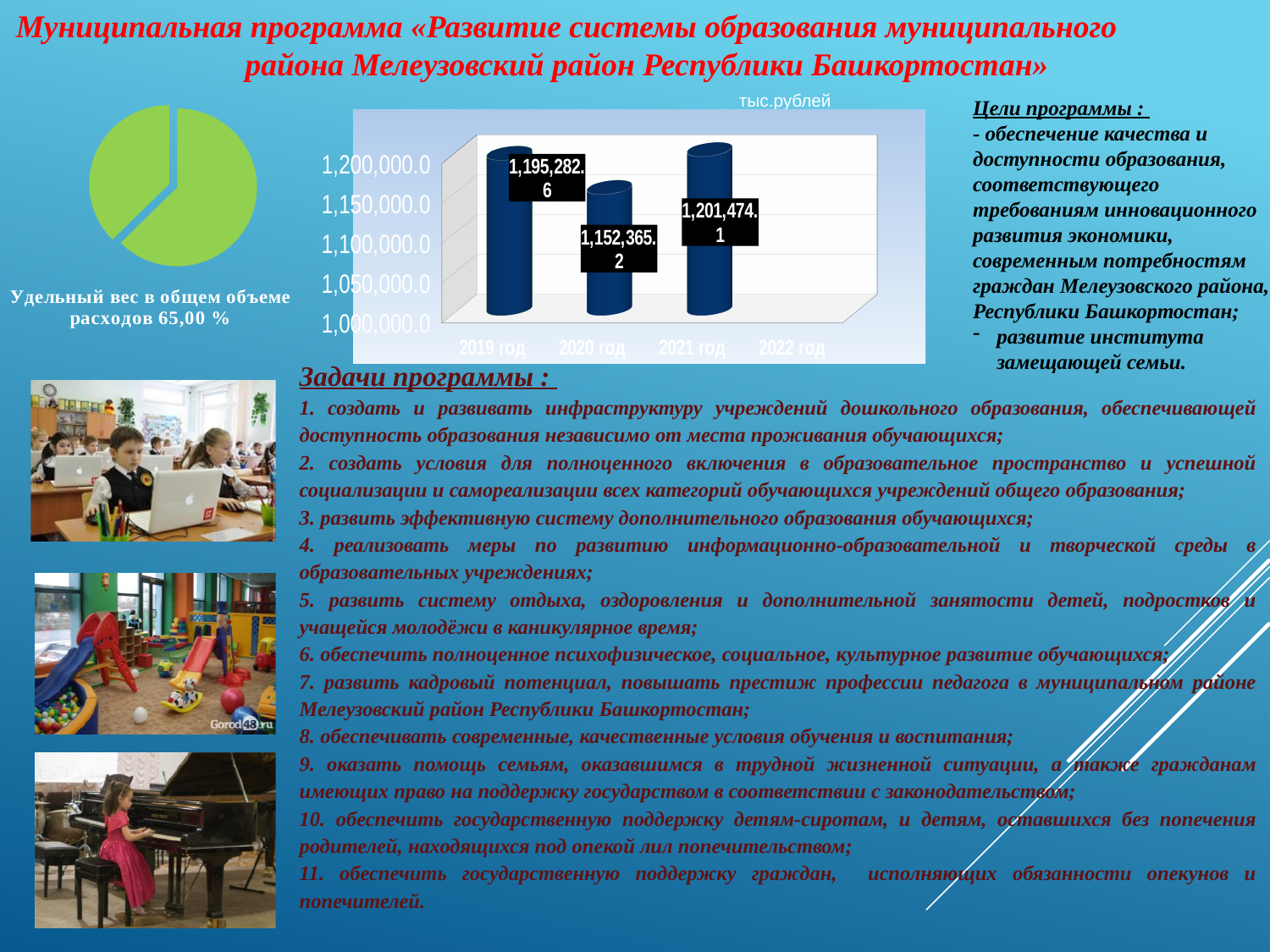
On the bar chart, what is the difference between the values for 2019 год and 2020 год? 42,917.4 On the bar chart, which year has the lowest value? 2020 год How many bars are plotted on the bar chart? 3 What kind of chart is the chart on the left of the slide? pie chart On the bar chart, what is the value for 2020 год? 1,152,365.2 On the bar chart, which is larger: the value for 2019 год or for 2021 год? 2021 год On the bar chart, what is the value for 2019 год? 1,195,282.6 What unit is shown above the bar chart? тыс.рублей On the bar chart, does the value rise or fall from 2019 год to 2020 год? fall On the bar chart, what is the value for 2021 год? 1,201,474.1 On the bar chart, what is the difference between the values for 2021 год and 2020 год? 49,108.9 On the bar chart, which year has the highest value? 2021 год